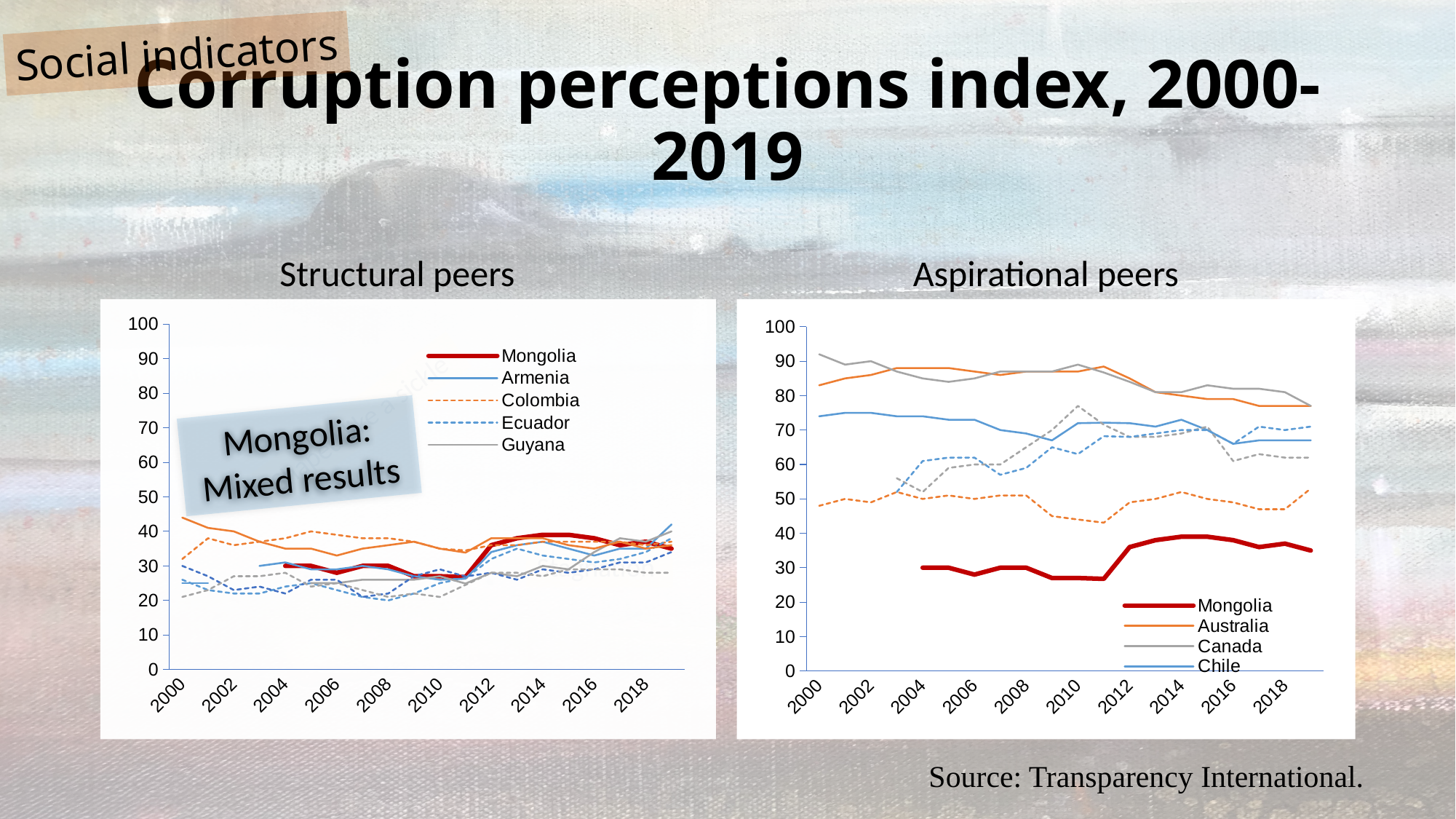
In the Aspirational peers chart, does the value for Canada rise or fall from 2000 to 2018? fall In the Aspirational peers chart, is the value for Mongolia in 2010 greater or less than 30? less In the Structural peers chart, is the value for Colombia in 2000 greater or less than 40? less In the Aspirational peers chart, does the value for Mongolia rise or fall from 2011 to 2014? rise In the Aspirational peers chart, which series has the highest value in 2000? Canada What is the source cited for the charts on the slide? Transparency International In the Aspirational peers chart, which series has the lowest value in 2018? Mongolia In the Aspirational peers chart, is the value for Canada in 2000 greater or less than 90? greater How many series does the legend of the Structural peers chart list? 5 What kind of chart is the Structural peers chart? line chart In the Aspirational peers chart, which is higher in 2018, Chile or Mongolia? Chile How many series does the legend of the Aspirational peers chart list? 4